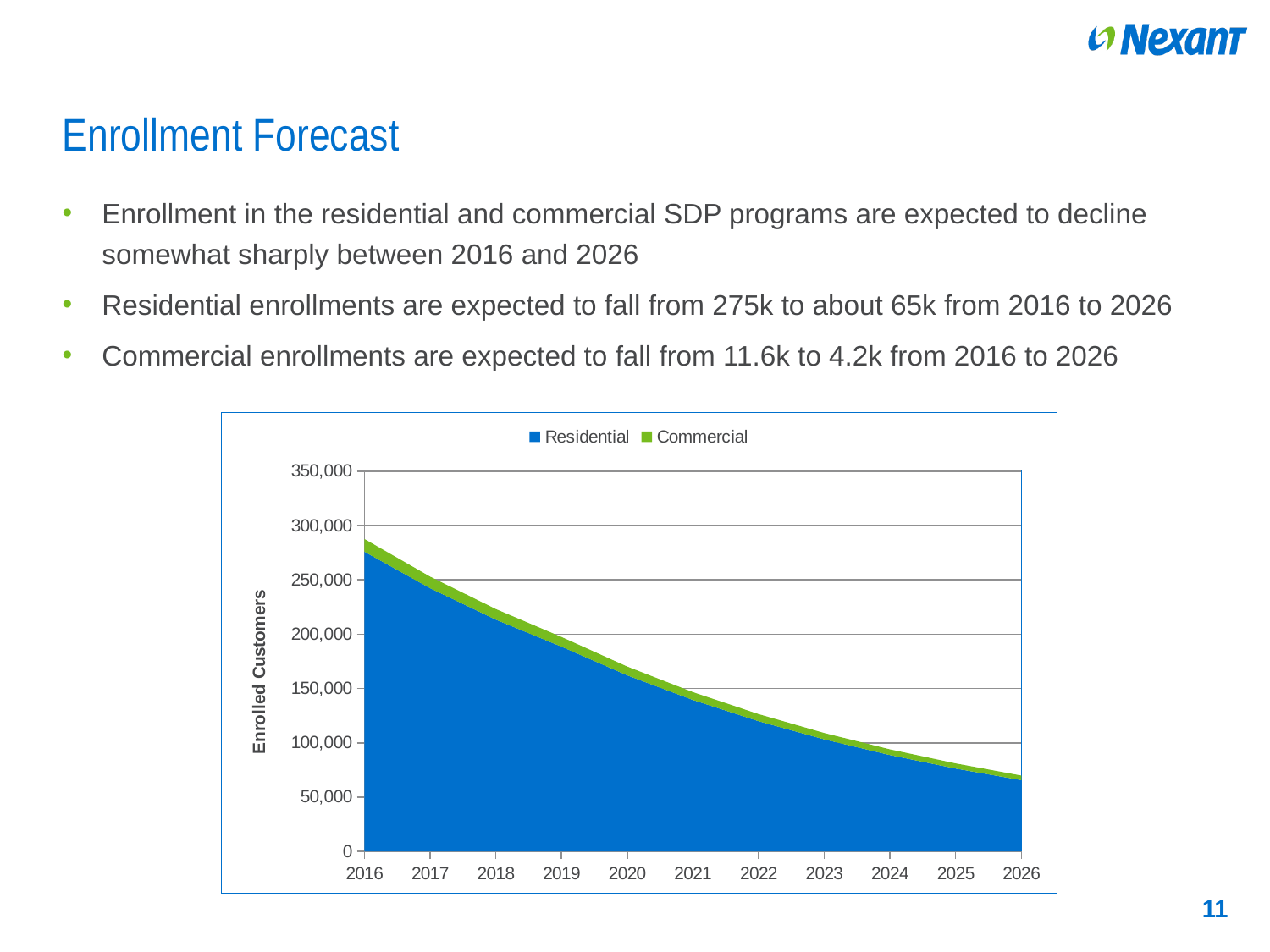
Is the total enrolled customers for 2026 greater or less than 100,000? less Is the total enrolled customers for 2016 greater or less than 300,000? less In which year is total enrollment highest in the chart? 2016 What kind of chart is shown on the slide? Stacked area chart What is the label on the vertical axis of the chart? Enrolled Customers Is the Residential value for 2016 greater or less than 250,000? greater Which series is larger in the chart, Residential or Commercial? Residential Do enrolled customers rise or fall from 2016 to 2026 in the chart? Fall How many series does the chart legend list? 2 In which year is total enrollment lowest in the chart? 2026 How many years are shown along the x axis of the chart? 11